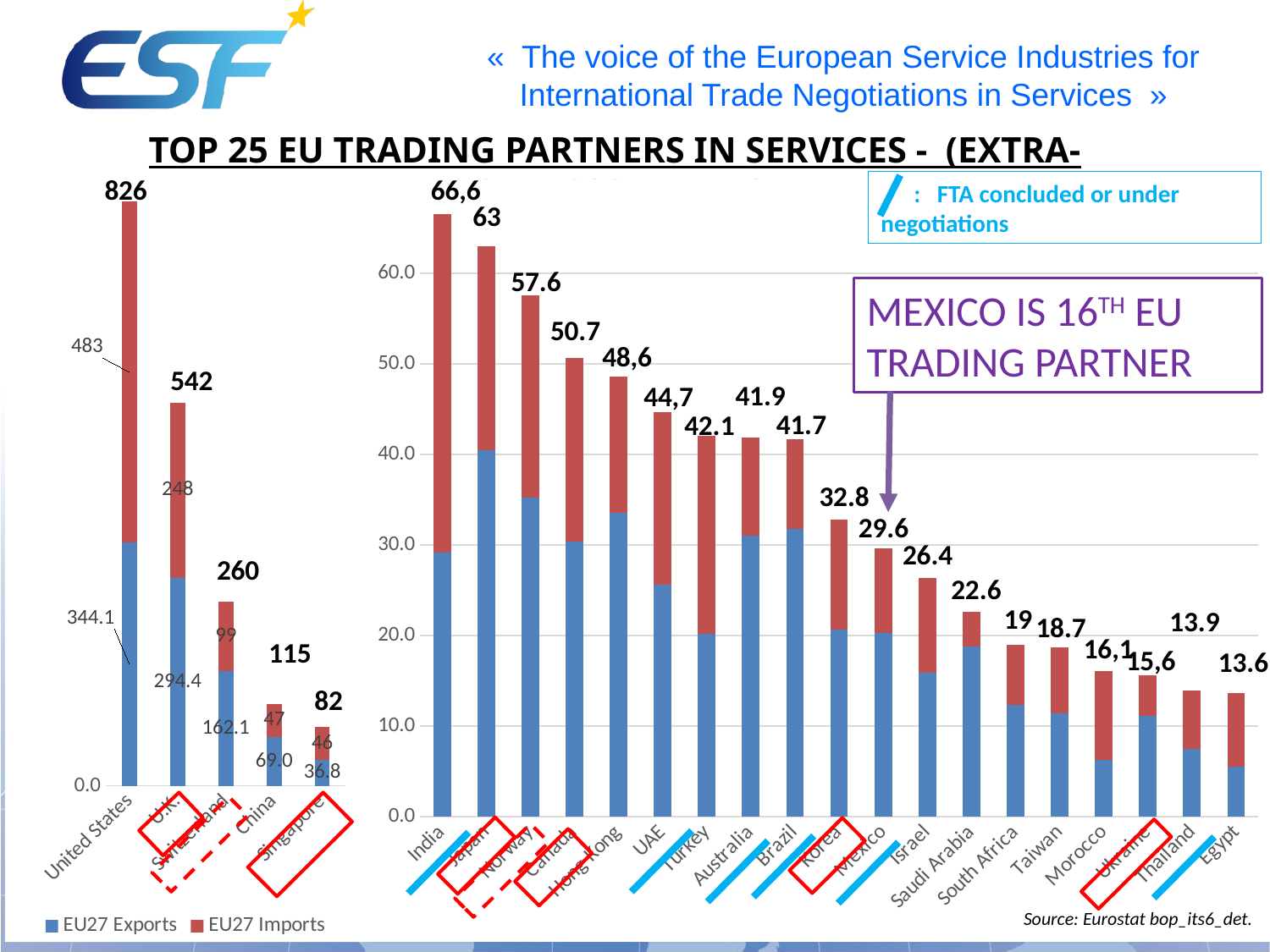
On the left chart, what is the EU27 Exports value for China? 69.0 On the right chart, what is the total value shown for Mexico? 29.6 On the right chart, do the totals rise or fall from left to right? Fall How many countries are shown on the right chart? 19 On the right chart, which has the larger total, Korea or Israel? Korea On the left chart, what is the EU27 Imports value for United States? 483 On the right chart, what is the difference between the totals for Japan and Norway? 5.4 How many series does the legend list? 2 On the left chart, what is the total value shown for United States? 826 On the right chart, which country has the highest total? India On the right chart, which country has the lowest total? Egypt What kind of chart is used on the slide? Stacked bar chart